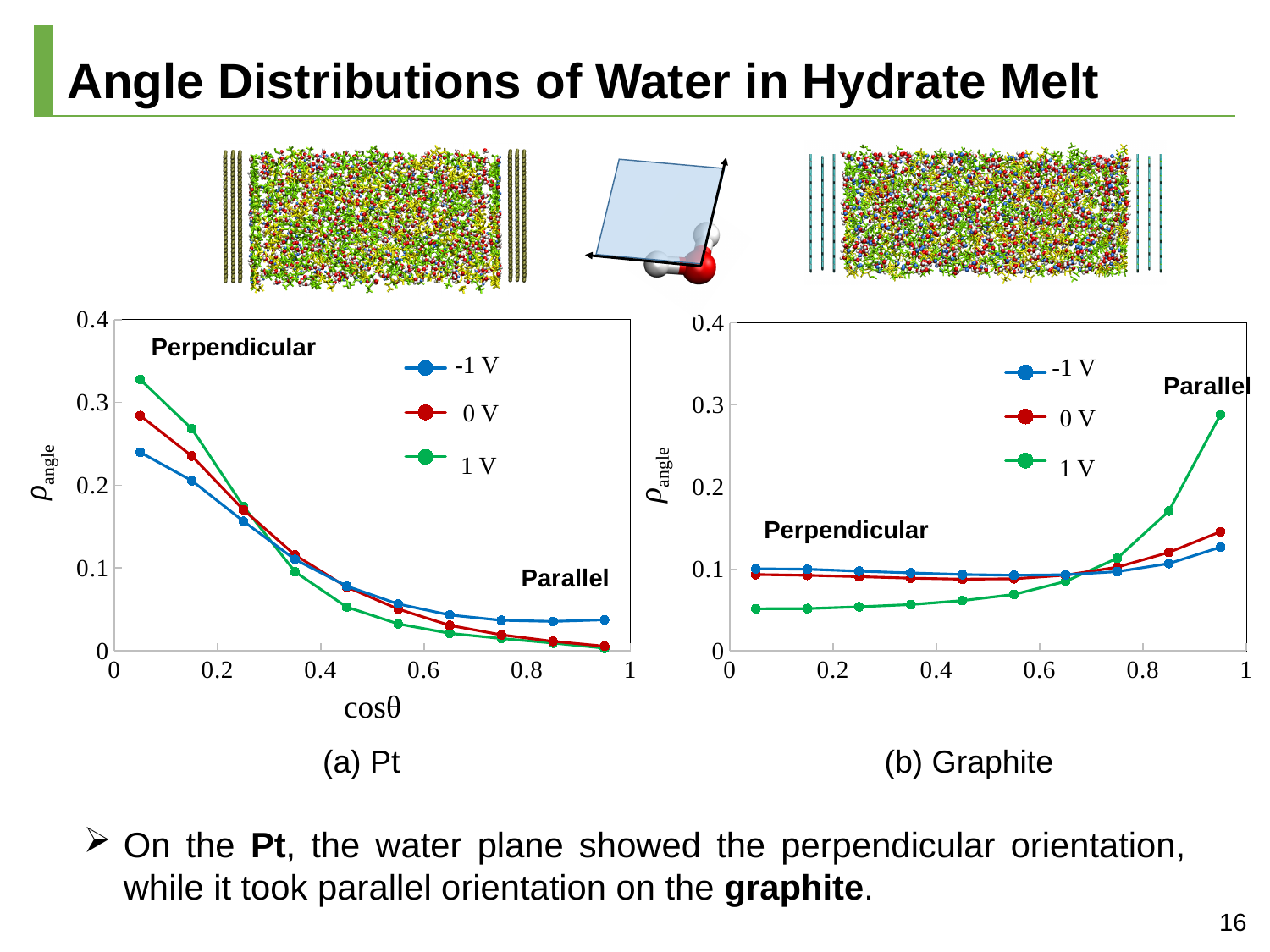
In the (b) Graphite chart, is the value of the 1 V series at its rightmost point greater or less than 0.2? greater In the (b) Graphite chart, which series has the lowest value at the leftmost point? 1 V In the (b) Graphite chart, do the values of the 1 V series rise or fall as cosθ increases? rise In the (b) Graphite chart, at the rightmost point, which is larger: the 1 V series or the -1 V series? 1 V What is the x-axis label of the (a) Pt chart? cosθ What kind of chart is the (a) Pt chart? line chart In the (a) Pt chart, do the values of the 1 V series rise or fall as cosθ increases? fall In the (a) Pt chart, which series has the highest value at the leftmost point? 1 V How many series does the legend of the (b) Graphite chart list? 3 In the (a) Pt chart, how many data points does the 1 V series have? 10 In the (a) Pt chart, is the value of the 1 V series at its leftmost point greater or less than 0.3? greater In the (b) Graphite chart, is the value of the 1 V series at its leftmost point greater or less than 0.1? less